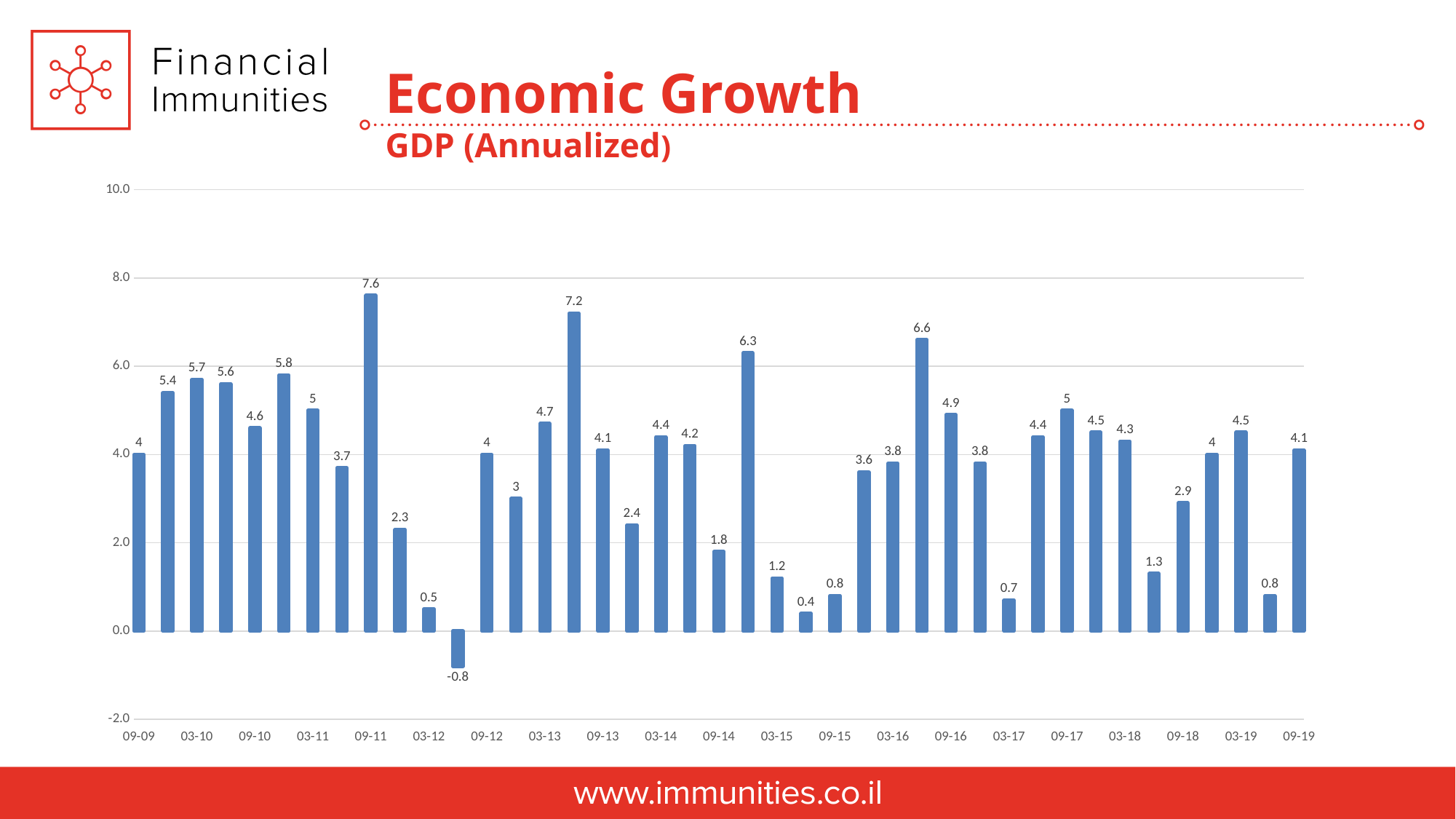
What is the GDP (Annualized) value for 09-11? 7.6 Which labeled period has the highest GDP (Annualized) value? 09-11 What is the GDP (Annualized) value for 09-19? 4.1 How many bars are plotted on the chart? 41 What is the lowest value shown on the chart? -0.8 What is the subtitle of the chart? GDP (Annualized) What is the GDP (Annualized) value for 03-17? 0.7 Which is larger, the value for 03-10 or the value for 09-18? 03-10 What is the GDP (Annualized) value for 09-16? 4.9 What type of chart is shown on the slide? bar chart Is the value for 09-14 greater or less than 2.0? less What is the difference between the values for 09-11 and 03-12? 7.1